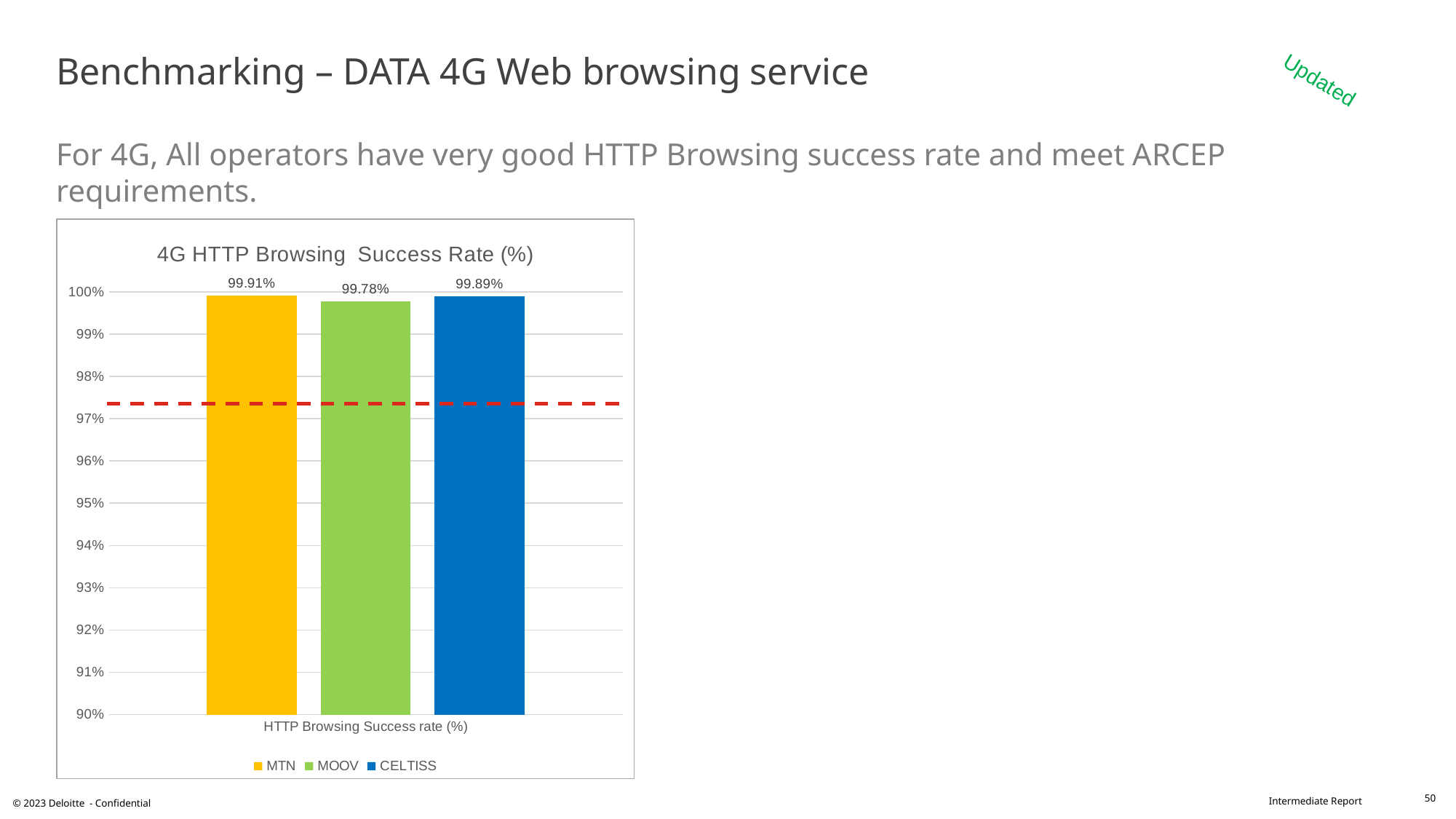
Which operator has the highest 4G HTTP Browsing success rate? MTN What is the 4G HTTP Browsing success rate for MOOV? 99.78% What is the difference between MTN's and MOOV's 4G HTTP Browsing success rates? 0.13% What type of chart is used to show the 4G HTTP Browsing Success Rate? Bar chart Which operator has the lowest 4G HTTP Browsing success rate? MOOV How many operators are shown in the 4G HTTP Browsing Success Rate chart? 3 What is the 4G HTTP Browsing success rate for CELTISS? 99.89% What is the difference between CELTISS's and MOOV's 4G HTTP Browsing success rates? 0.11% Is the 4G HTTP Browsing success rate for MOOV greater or less than 98%? greater Which has a higher 4G HTTP Browsing success rate, MOOV or CELTISS? CELTISS What is the 4G HTTP Browsing success rate for MTN? 99.91% What colour is the bar for CELTISS in the chart? Blue